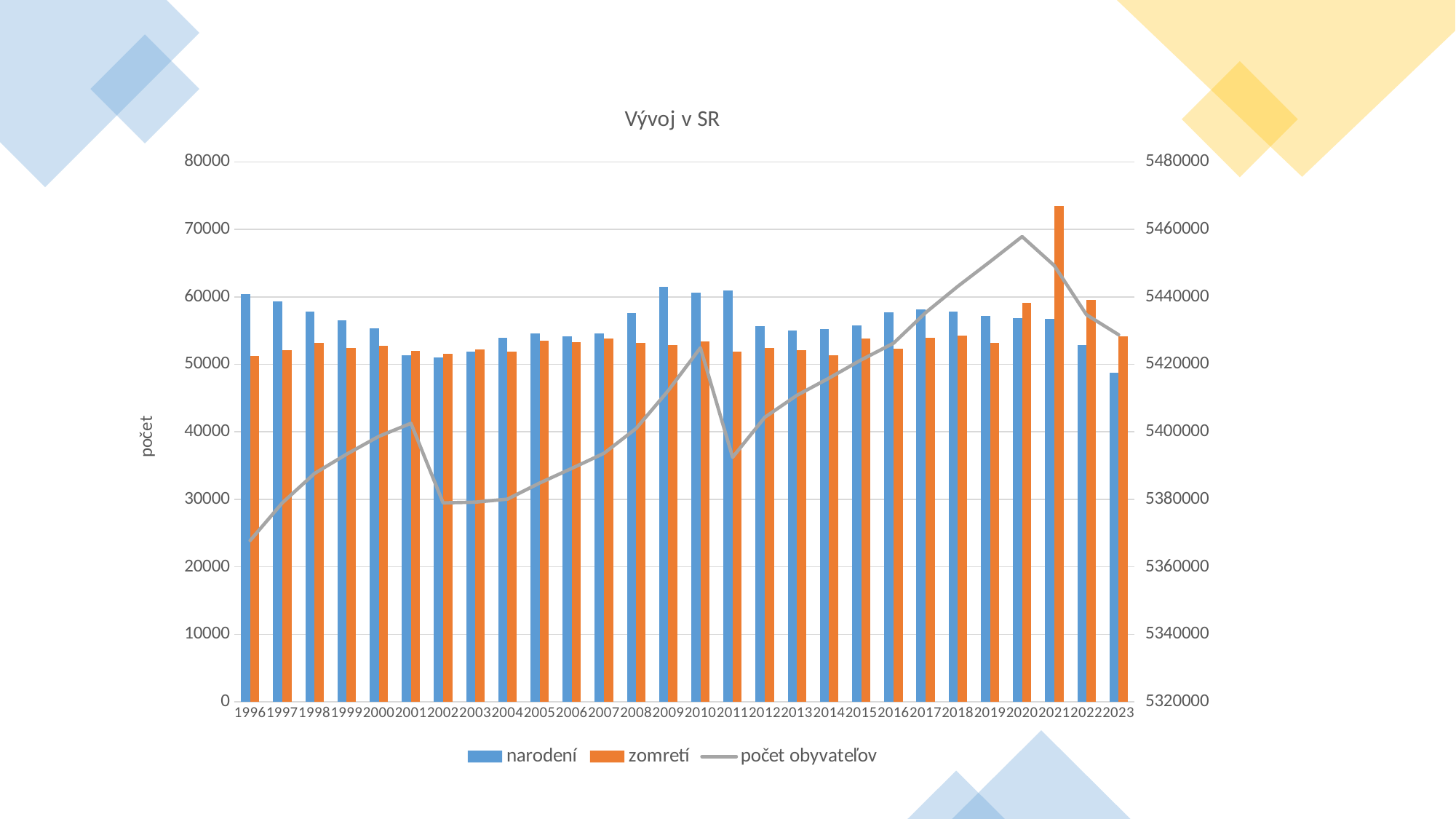
In 2021, which is larger: narodení or zomretí? zomretí Does the počet obyvateľov line rise or fall between 2011 and 2020? rise How many series does the legend list? 3 What kind of chart is shown on the slide? A combined bar and line chart In which year is the narodení bar the lowest? 2023 How many years are shown on the x axis? 28 In which year does the počet obyvateľov line reach its highest point? 2020 In which year is the zomretí bar the highest? 2021 Is the zomretí value for 2021 greater or less than 70000? greater Is the narodení value for 2023 greater or less than 50000? less In 1996, which is larger: narodení or zomretí? narodení What is the title of the chart? Vývoj v SR